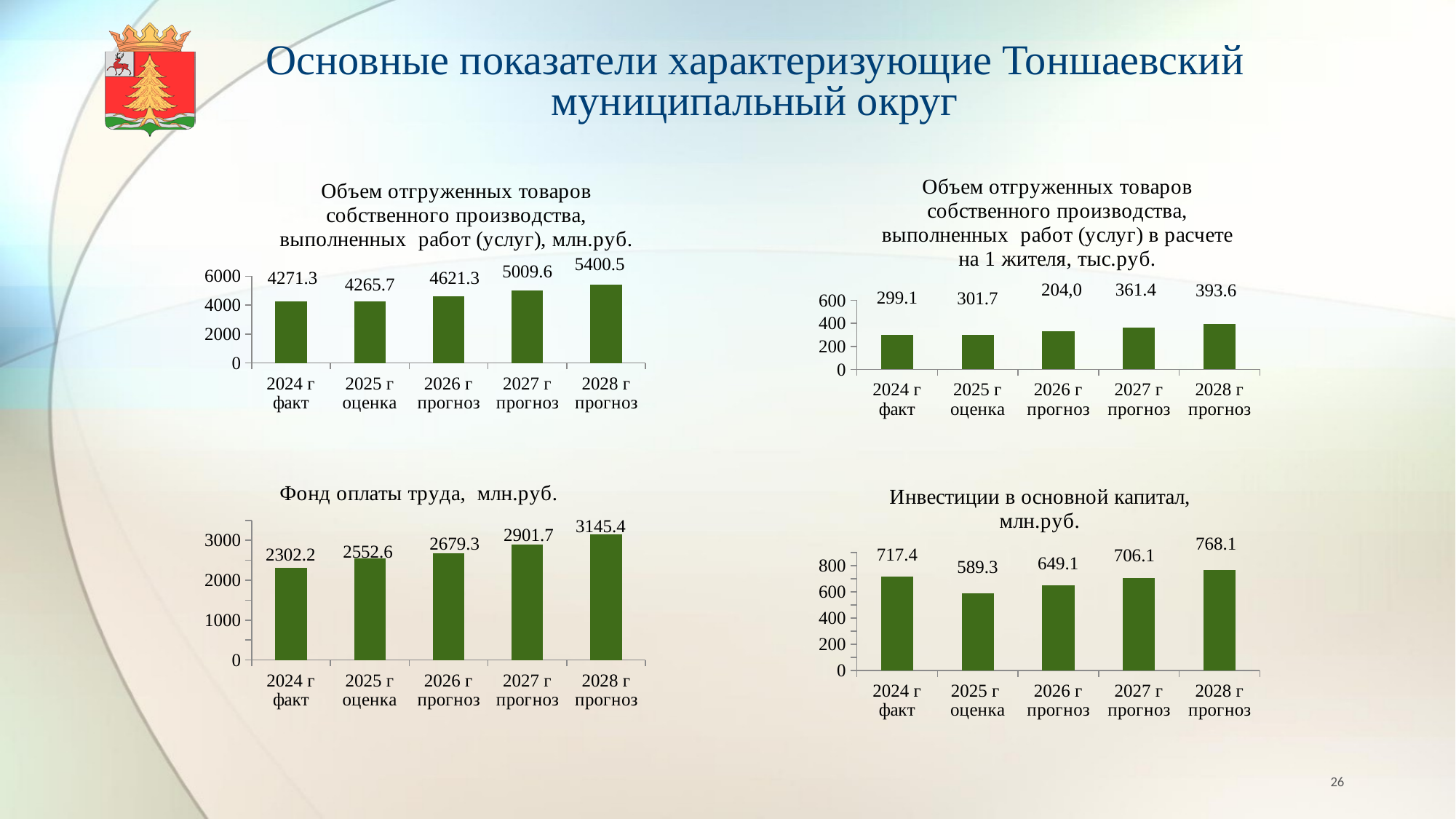
In the top-right chart (per capita, тыс.руб.), which year has the highest value? 2028 г прогноз In the bottom-left chart (Фонд оплаты труда), what is the value for 2026 г прогноз? 2679.3 In the bottom-right chart (Инвестиции в основной капитал), which is larger: the value for 2024 г факт or 2027 г прогноз? 2024 г факт How many categories (years) are shown in the bottom-right chart (Инвестиции в основной капитал)? 5 In the top-left chart (Объем отгруженных товаров ... млн.руб.), which year has the lowest value? 2025 г оценка In the bottom-right chart (Инвестиции в основной капитал), what is the value for 2025 г оценка? 589.3 In the top-right chart (per capita, тыс.руб.), what is the value for 2027 г прогноз? 361.4 In the bottom-left chart (Фонд оплаты труда), is the value for 2024 г факт greater or less than 2000? greater In the top-left chart (Объем отгруженных товаров ... млн.руб.), what is the difference between the 2028 г прогноз and 2024 г факт values? 1129.2 In the top-left chart (Объем отгруженных товаров ... млн.руб.), what is the value for 2028 г прогноз? 5400.5 In the bottom-left chart (Фонд оплаты труда), do the values rise or fall from 2024 г to 2028 г? rise In the bottom-right chart (Инвестиции в основной капитал), what is the difference between the 2028 г прогноз and 2025 г оценка values? 178.8